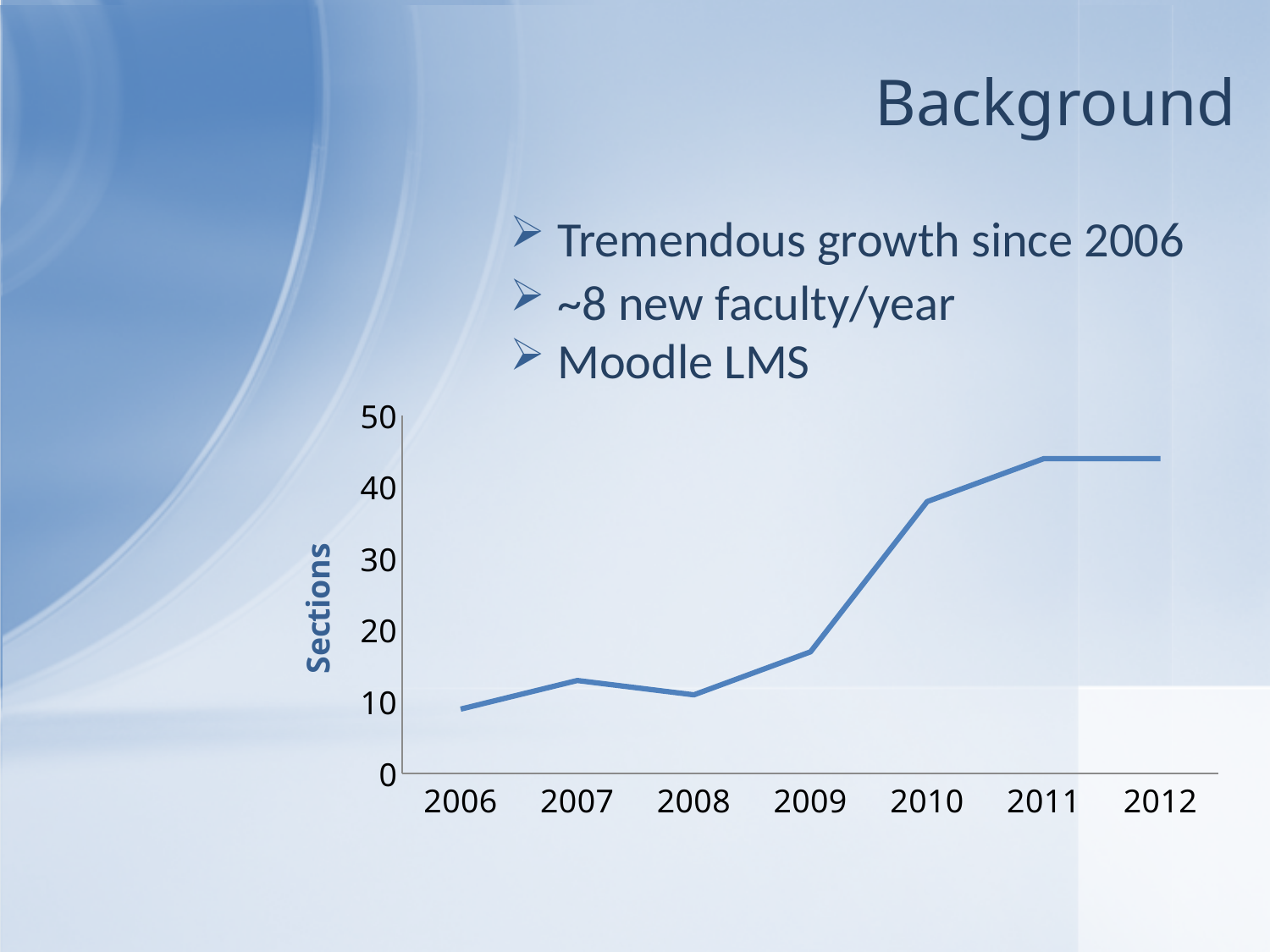
Is the value for 2012 greater or less than 50? less Is the value for 2011 greater or less than 40? greater Which is larger, the value for 2009 or the value for 2010? 2010 Is the value for 2010 greater or less than 30? greater Which is larger, the value for 2007 or the value for 2008? 2007 Do the values in the chart generally rise or fall from 2006 to 2012? rise What kind of chart is shown on the slide? line chart How many years are plotted along the x axis of the chart? 7 Which year has the lowest number of sections? 2006 What is the title of the vertical axis of the chart? Sections